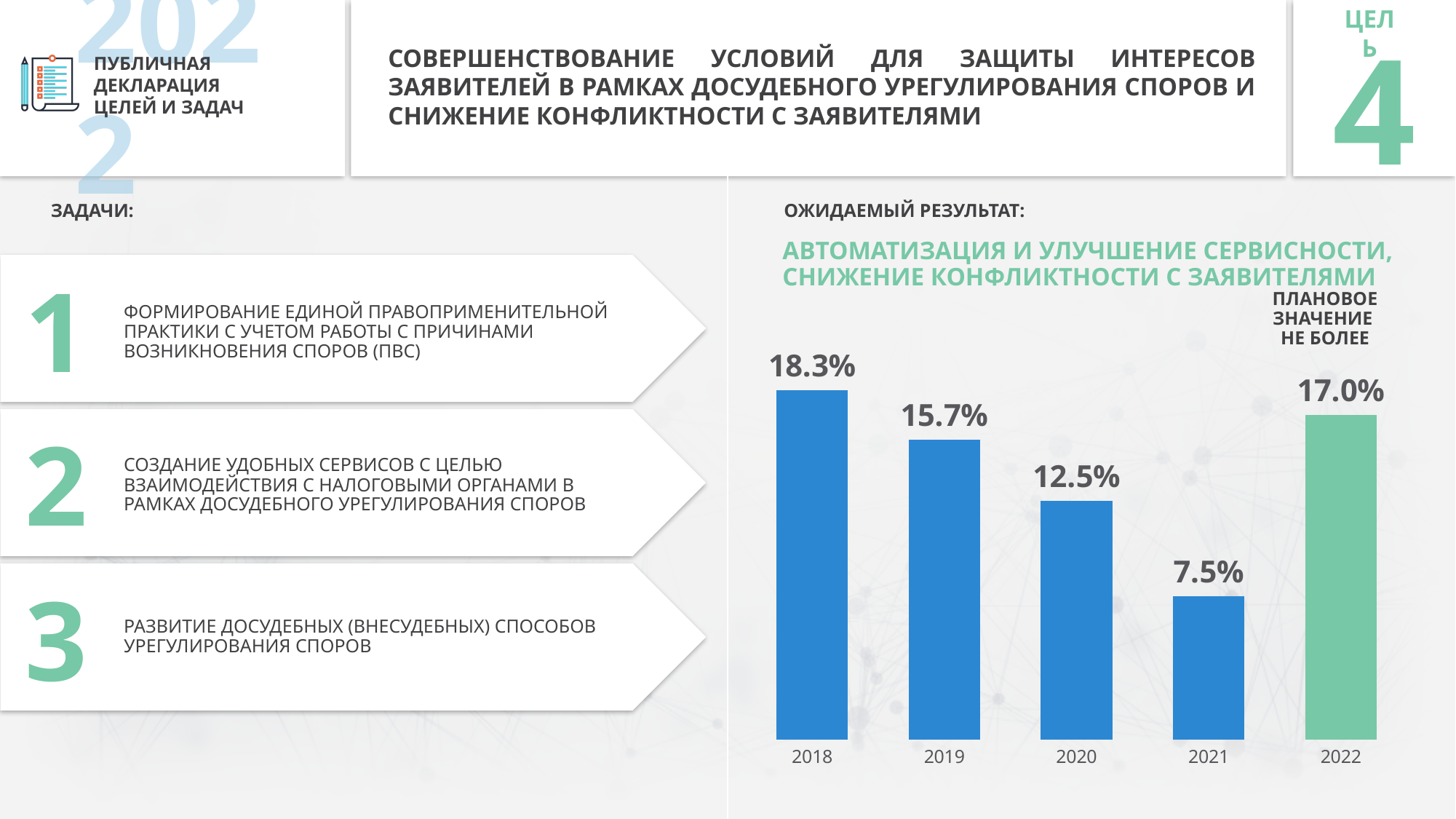
What is the value shown for 2021? 7.5% What is the difference between the values for 2020 and 2021? 5.0% Which bar on the chart is coloured green rather than blue? 2022 Which year has the lowest value on the chart? 2021 What is the difference between the values for 2018 and 2019? 2.6% What is the value shown for 2018? 18.3% What kind of chart is shown on the slide? Bar chart Which is larger, the value for 2019 or the value for 2022? 2022 Do the values rise or fall from 2018 to 2021? Fall What is the planned value shown for 2022? 17.0% How many years are shown on the chart? 5 Which year has the highest value on the chart? 2018